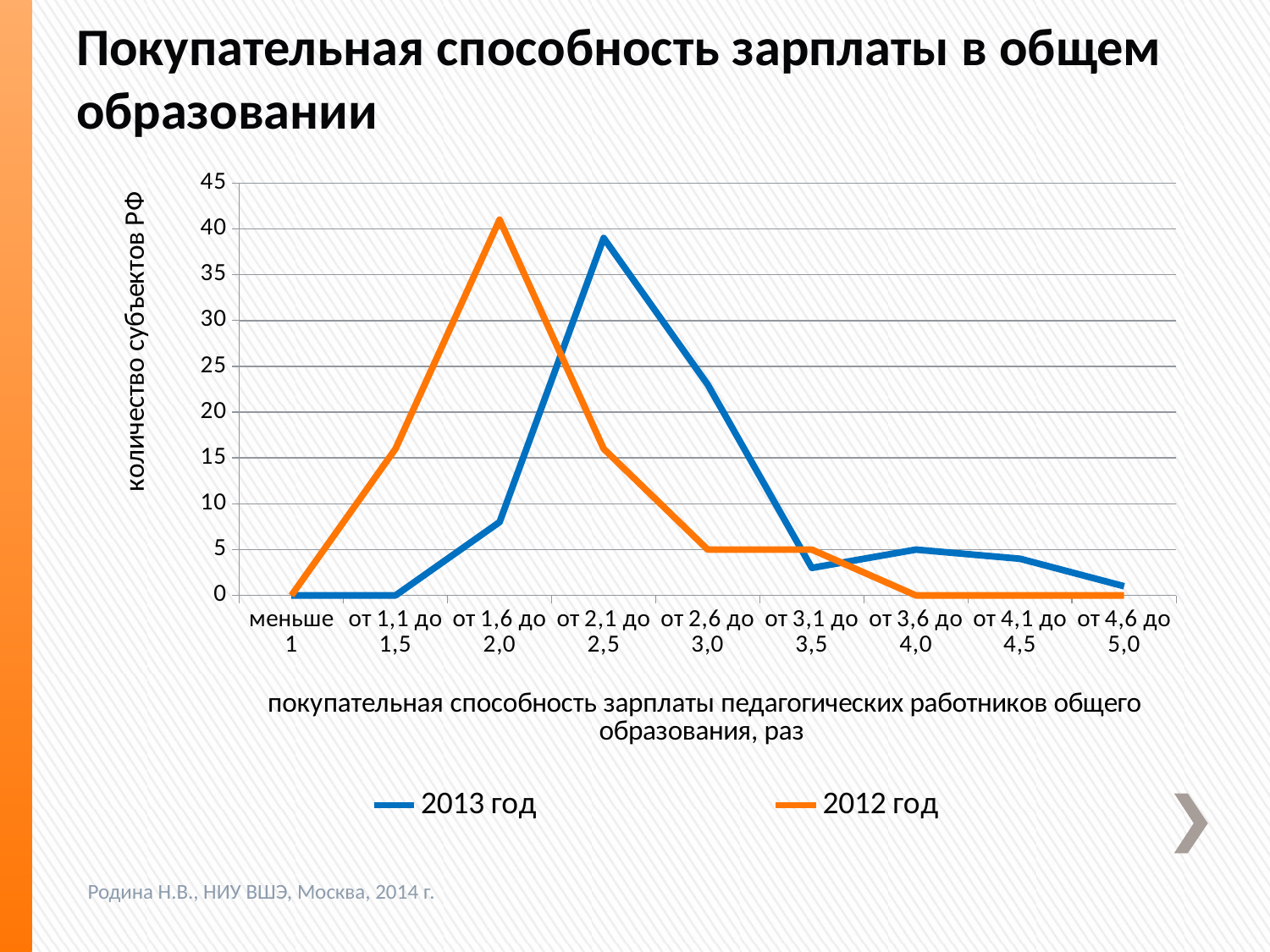
What kind of chart is shown on the slide? line chart In which category does the 2012 год series reach its highest value? от 1,6 до 2,0 How many categories are shown on the x axis? 9 In which category does the 2013 год series reach its highest value? от 2,1 до 2,5 What colour is the line for the 2012 год series? orange Is the value for 2013 год in the category 'от 1,6 до 2,0' greater or less than 10? less Does the 2013 год series rise or fall from 'от 2,1 до 2,5' to 'от 3,1 до 3,5'? fall What is the value for 2013 год in the category 'меньше 1'? 0 Which series has the larger value in the category 'от 2,1 до 2,5', 2013 год or 2012 год? 2013 год How many series does the legend list? 2 Is the value for 2012 год in the category 'от 1,6 до 2,0' greater or less than 35? greater What is the value for 2012 год in the category 'от 3,6 до 4,0'? 0